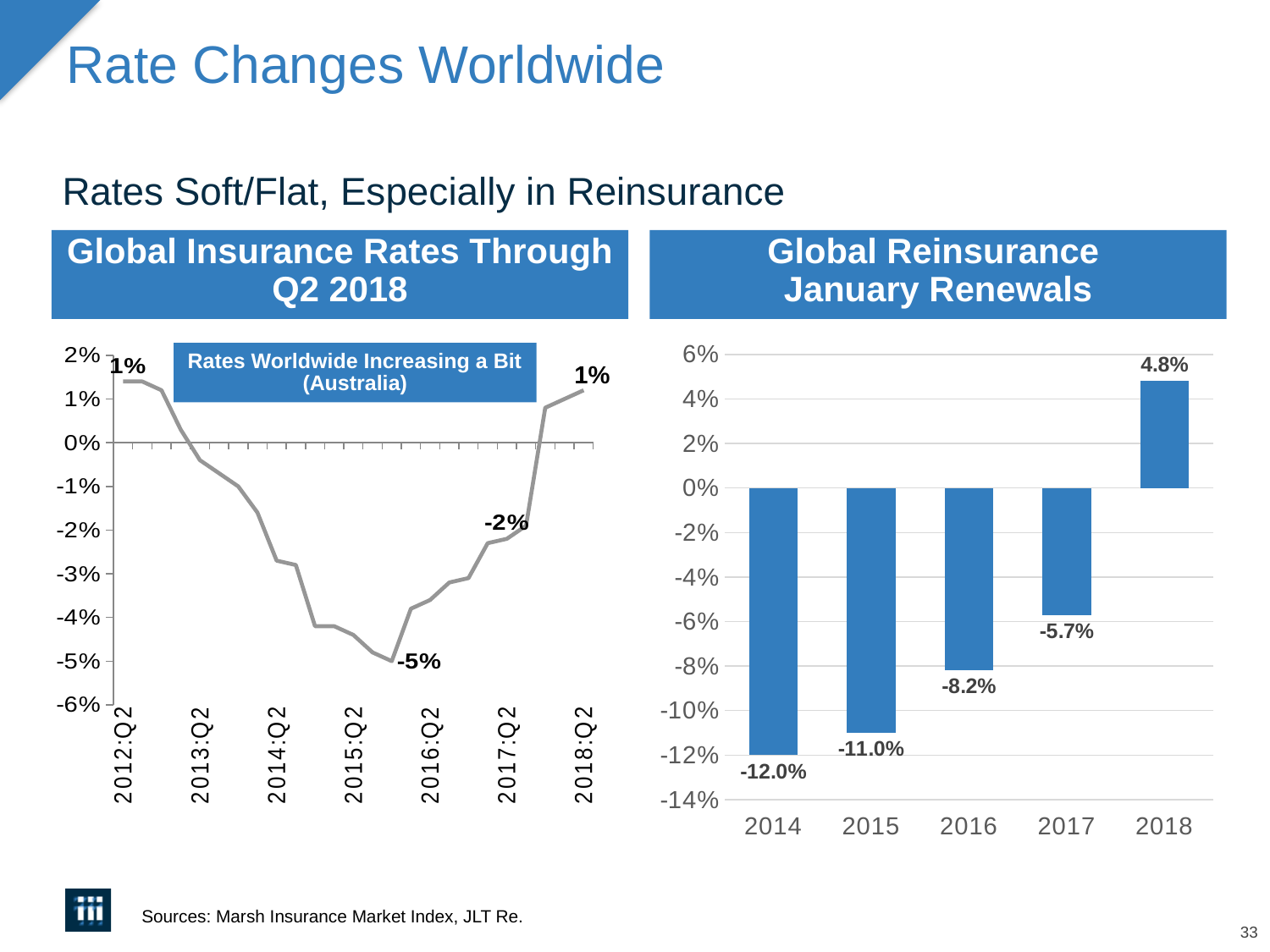
On the Global Insurance Rates Through Q2 2018 chart, is the value at 2014:Q2 greater or less than -2%? less On the Global Reinsurance January Renewals chart, do the values rise or fall from 2014 to 2018? rise On the Global Reinsurance January Renewals chart, which year has the lowest value? 2014 What kind of chart is the Global Insurance Rates Through Q2 2018 chart? line chart On the Global Insurance Rates Through Q2 2018 chart, what is the value labelled at 2018:Q2? 1% On the Global Insurance Rates Through Q2 2018 chart, what is the lowest value labelled on the line? -5% On the Global Reinsurance January Renewals chart, what is the difference between the 2015 value and the 2014 value? 1.0 percentage point What kind of chart is the Global Reinsurance January Renewals chart? bar chart On the Global Reinsurance January Renewals chart, what is the value for 2018? 4.8% On the Global Reinsurance January Renewals chart, which year has the highest value? 2018 On the Global Reinsurance January Renewals chart, what is the value for 2016? -8.2% On the Global Reinsurance January Renewals chart, how many years are shown? 5